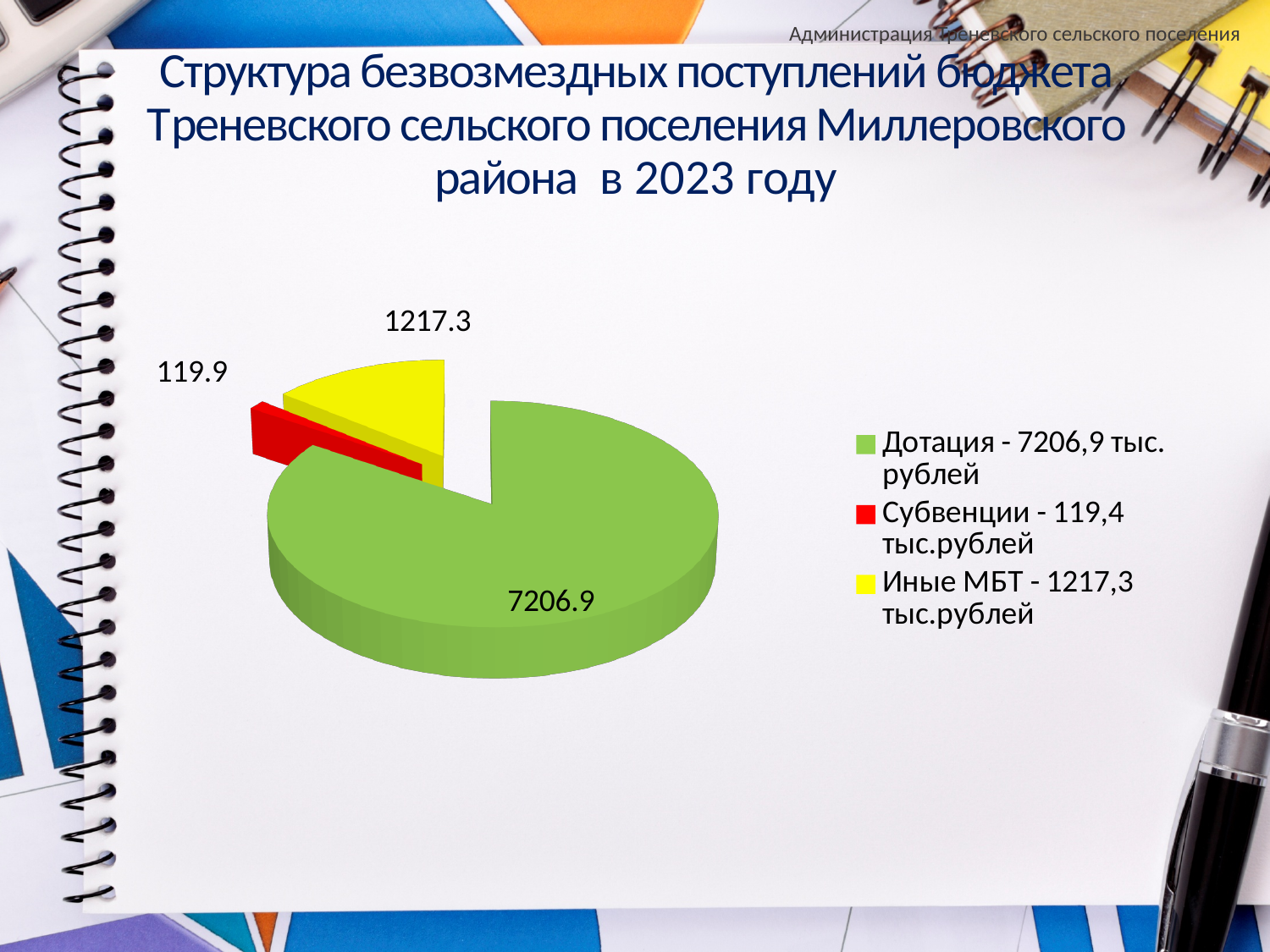
Which category has the smallest slice in the pie chart? Субвенции What value is shown on the slice for Иные МБТ? 1217.3 What is the difference between the values for Дотация and Иные МБТ? 5989.6 How many entries does the legend list? 3 What data label is printed next to the red slice (Субвенции)? 119.9 Which is larger, the slice for Дотация or the slice for Иные МБТ? Дотация Which is larger, the slice for Иные МБТ or the slice for Субвенции? Иные МБТ What colour is the slice for Дотация? green Which category has the largest slice in the pie chart? Дотация What kind of chart is shown on the slide? pie chart What value is shown on the slice for Дотация? 7206.9 How many slices does the pie chart have? 3